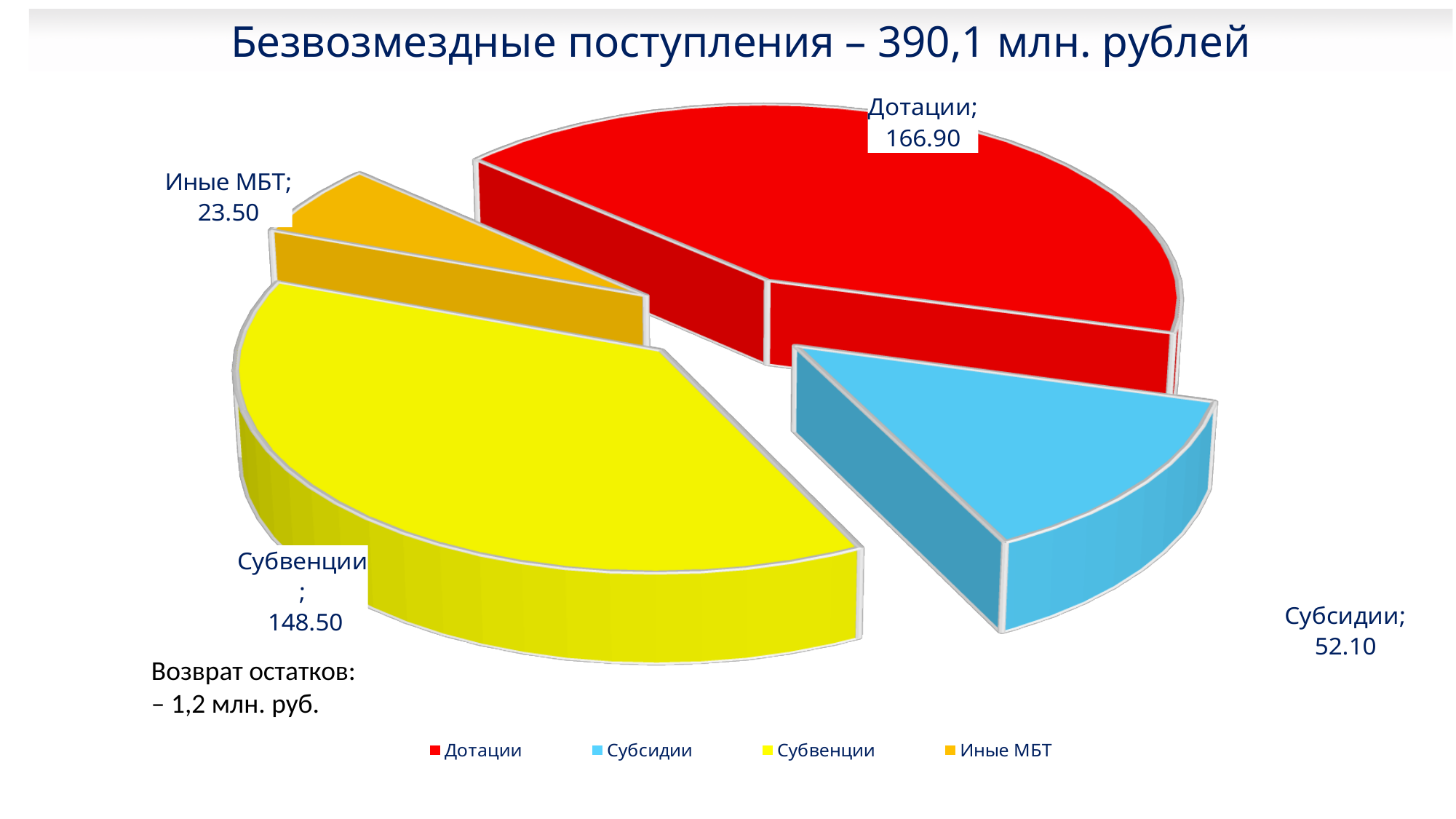
Which category has the largest slice? Дотации How many categories does the pie chart have? 4 Which category has the smallest slice? Иные МБТ What is the difference between the values for Дотации and Субвенции? 18.40 What is the value for Дотации? 166.90 What type of chart is shown on the slide? pie chart What is the difference between the values for Субсидии and Иные МБТ? 28.60 What is the value for Субвенции? 148.50 Which is larger, the value for Субсидии or the value for Субвенции? Субвенции What is the title of the slide? Безвозмездные поступления – 390,1 млн. рублей What is the value for Иные МБТ? 23.50 What is the value for Субсидии? 52.10